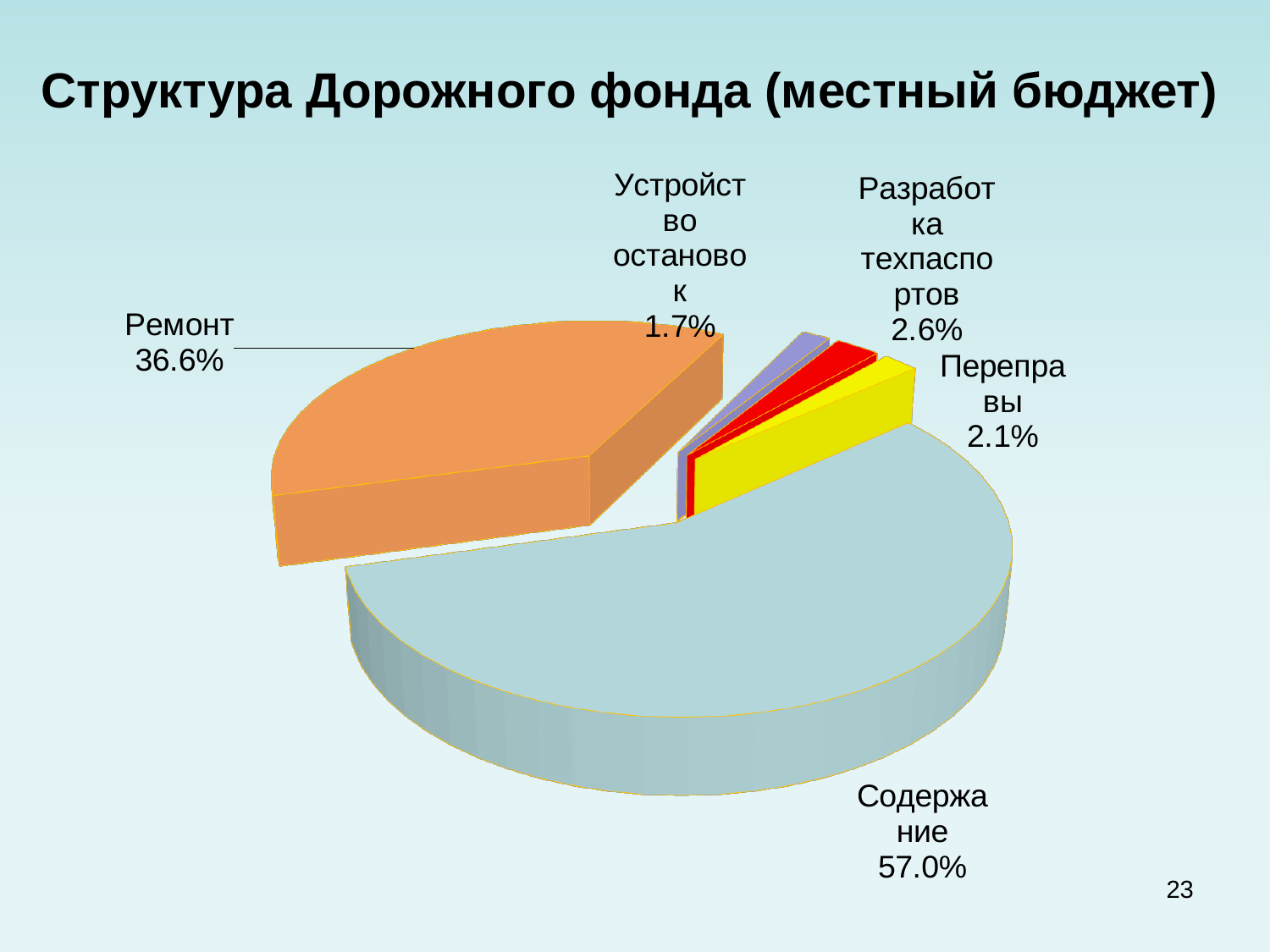
What is the difference in percentage points between Содержание and Ремонт? 20.4 What type of chart is shown on the slide? pie chart What share of the pie does Содержание have? 57.0% What share of the pie does Ремонт have? 36.6% Which is larger, the share for Разработка техпаспортов or the share for Переправы? Разработка техпаспортов What share of the pie does Переправы have? 2.1% Which category has the smallest share of the pie? Устройство остановок What share of the pie does Разработка техпаспортов have? 2.6% What share of the pie does Устройство остановок have? 1.7% What is the title of the chart on the slide? Структура Дорожного фонда (местный бюджет) How many slices does the pie chart have? 5 Which category has the largest share of the pie? Содержание